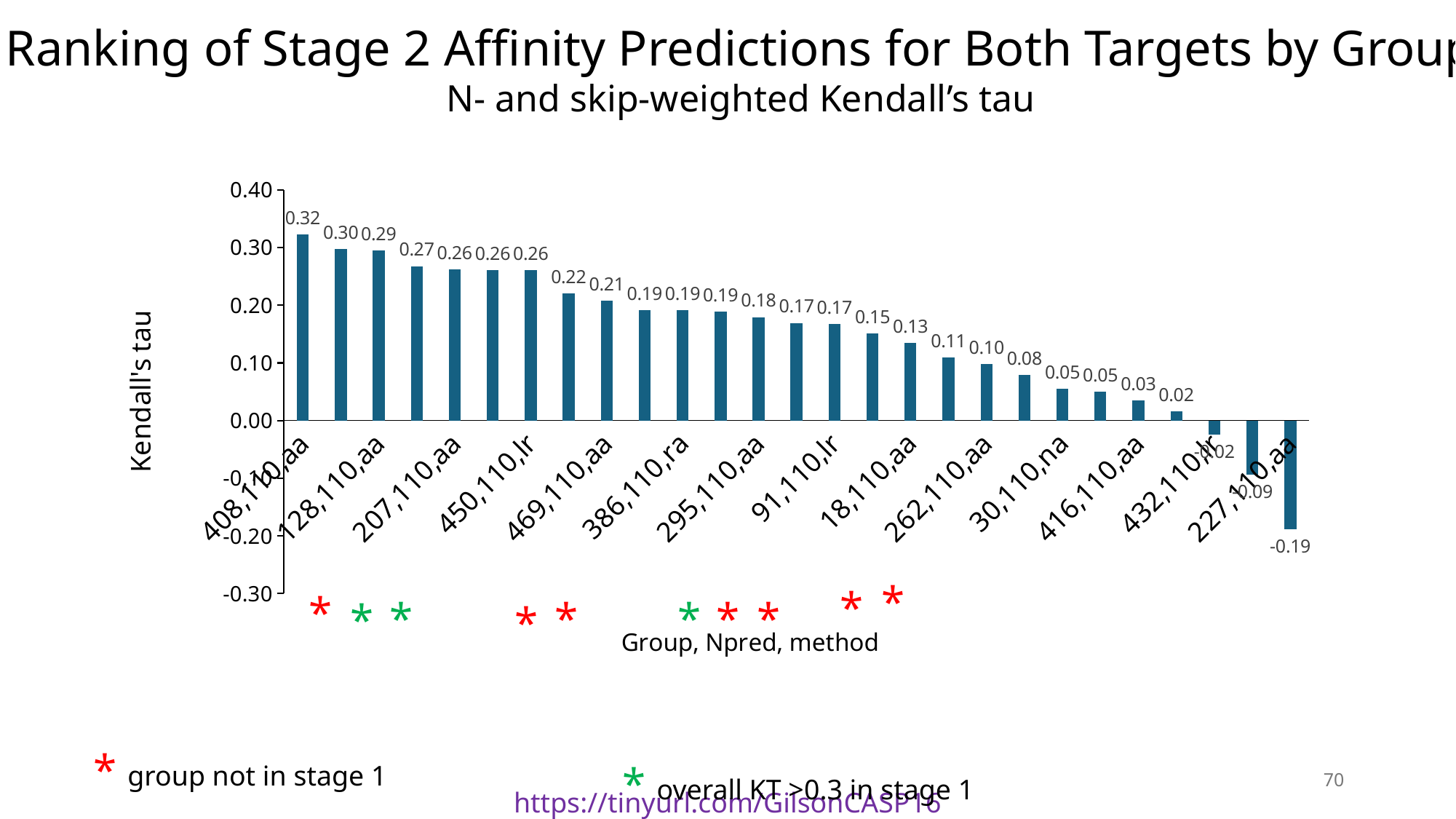
Which has a larger Kendall's tau, group 408,110,aa or group 227,110,aa? 408,110,aa Which group has the lowest Kendall's tau? 227,110,aa What is the Kendall's tau value for group 408,110,aa? 0.32 Which group has the highest Kendall's tau? 408,110,aa Do the Kendall's tau values rise or fall from left to right along the x axis? fall Is the Kendall's tau for group 408,110,aa greater or less than 0.30? greater What is the label of the y axis? Kendall's tau What is the difference between the highest Kendall's tau (0.32) and the lowest (-0.19)? 0.51 How many bars are plotted in the chart? 27 What is the Kendall's tau value for group 227,110,aa? -0.19 What type of chart is shown on the slide? bar chart What is the Kendall's tau value for group 128,110,aa? 0.29